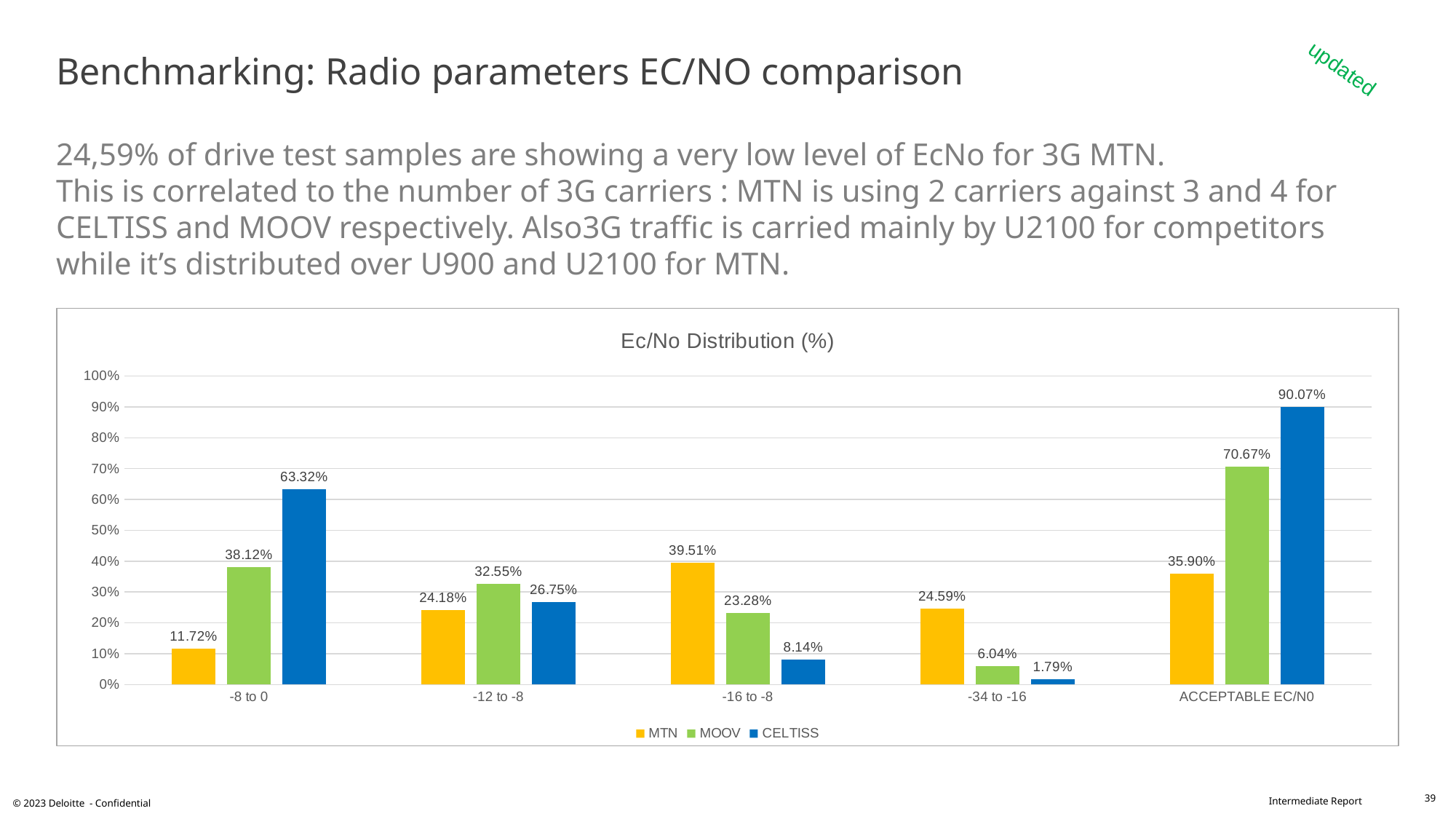
How many categories are shown on the x axis? 5 What is the value for CELTISS in the -8 to 0 category? 63.32% How many series does the legend list? 3 What is the difference between the CELTISS and MTN values in the ACCEPTABLE EC/N0 category? 54.17% What is the title of the chart? Ec/No Distribution (%) What kind of chart is shown on the slide? Bar chart Which is larger in the -16 to -8 category, MTN or MOOV? MTN Is the value for MOOV in the -12 to -8 category greater or less than 30%? greater What is the value for MTN in the -34 to -16 category? 24.59% What is the value for MOOV in the ACCEPTABLE EC/N0 category? 70.67% Which series has the highest value in the ACCEPTABLE EC/N0 category? CELTISS Which series has the lowest value in the -34 to -16 category? CELTISS